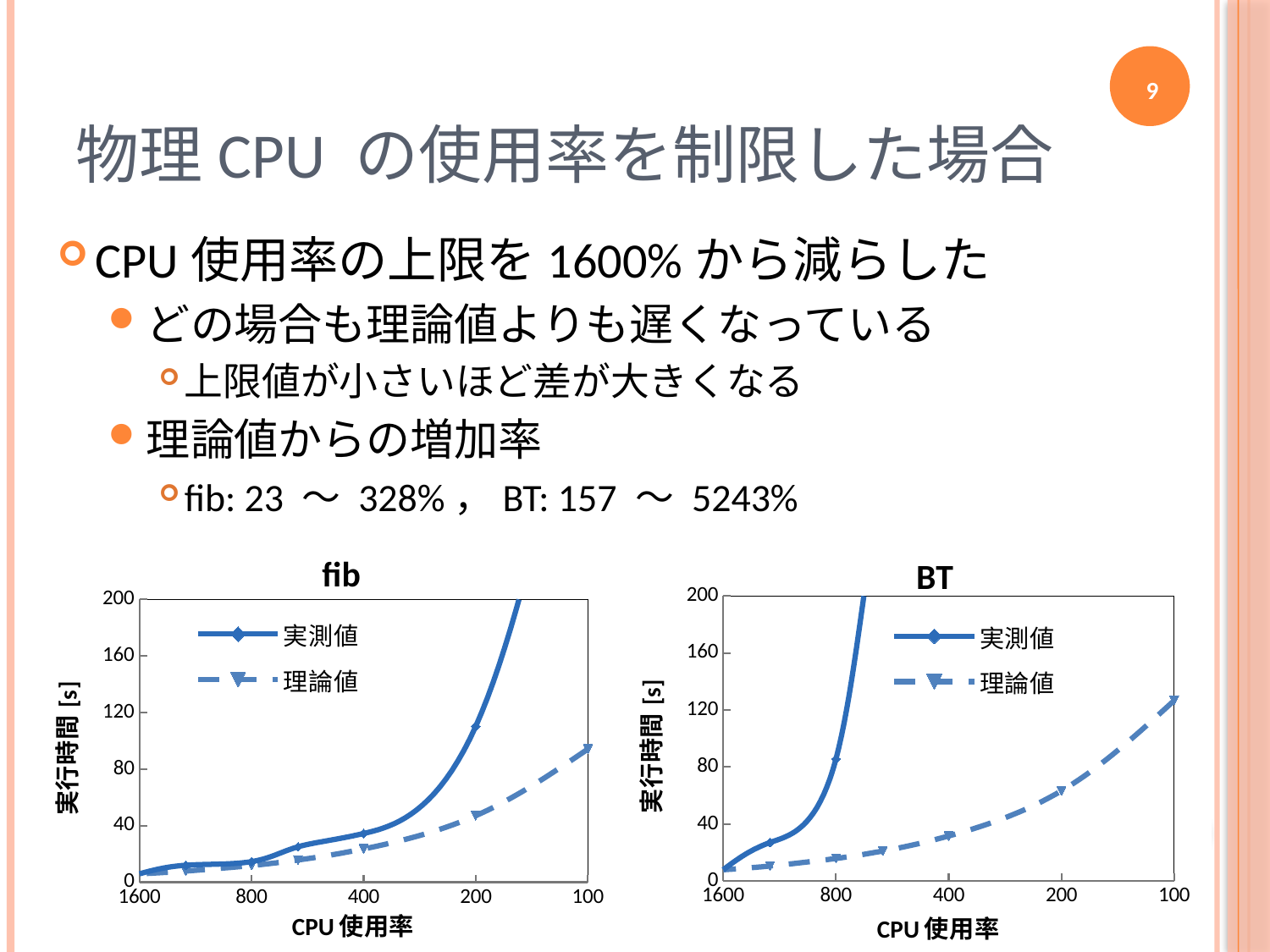
What is the y-axis label of the "BT" chart? 実行時間 [s] In the "fib" chart, is the 理論値 value at CPU 使用率 200 greater or less than 40? greater In the "fib" chart, does the 実測値 series rise or fall as you move from left to right along the x axis? rise In the "fib" chart, at CPU 使用率 200, which series has the larger value, 実測値 or 理論値? 実測値 In the "BT" chart, is the 理論値 value at CPU 使用率 200 greater or less than 80? less In the "fib" chart, which series is drawn with a dashed line? 理論値 How many series does the legend of the "BT" chart list? 2 In the "BT" chart, is the 理論値 value at CPU 使用率 100 greater or less than 100? greater What kind of chart is the "fib" chart? line chart In the "BT" chart, does the 理論値 series rise or fall as you move from left to right along the x axis? rise